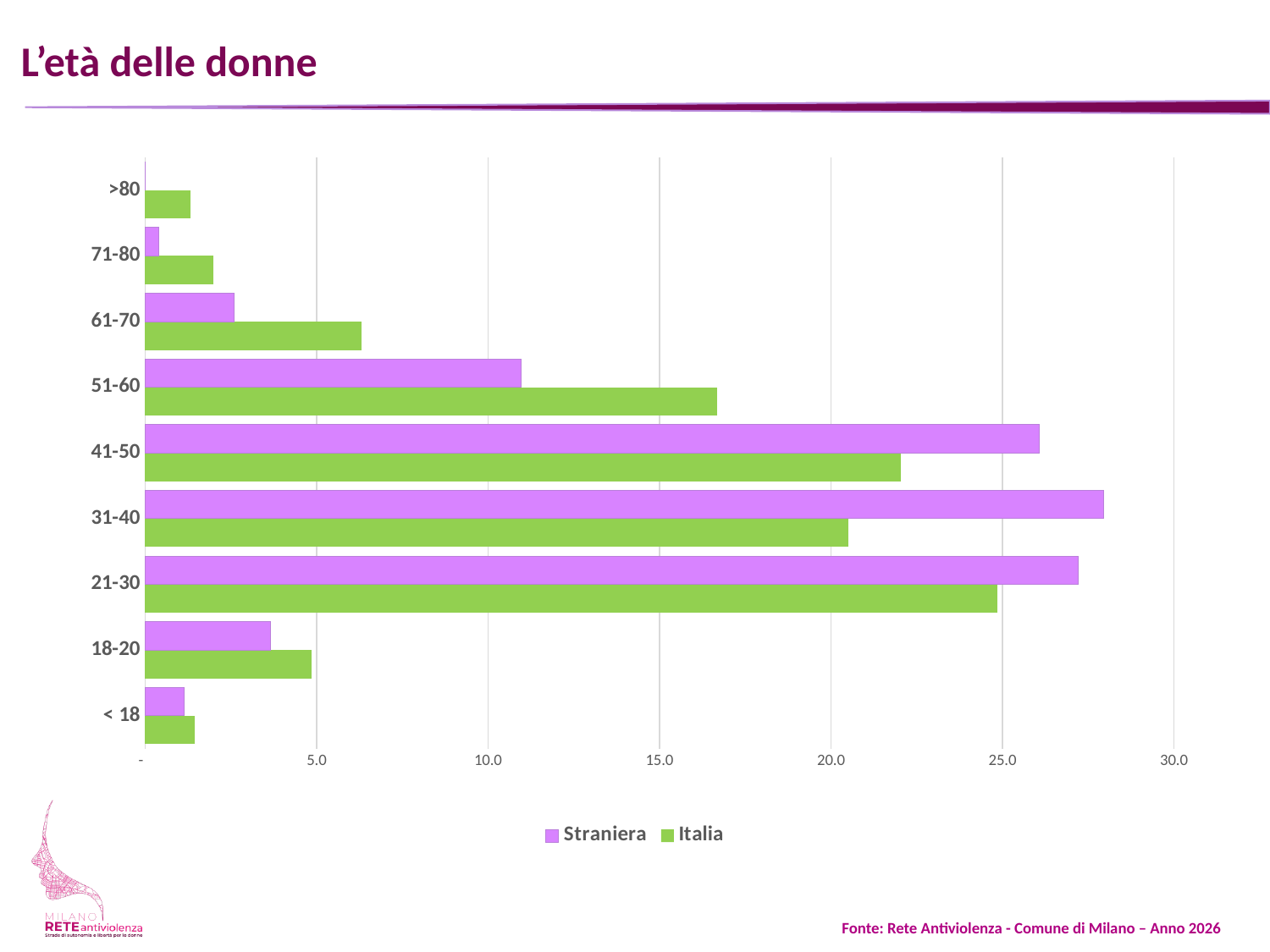
Is the Italia value for 61-70 greater or less than 5.0? greater For the 51-60 age category, which series has the larger value, Straniera or Italia? Italia Is the Straniera value for 31-40 greater or less than 25.0? greater For the 41-50 age category, which series has the larger value, Straniera or Italia? Straniera How many series does the legend list? 2 How many age categories are shown on the chart? 9 Which series is shown in green? Italia Is the Straniera value for 51-60 greater or less than 10.0? greater What kind of chart is shown on the slide? bar chart For which age category is the Italia value highest? 21-30 What is the title of the slide? L'età delle donne